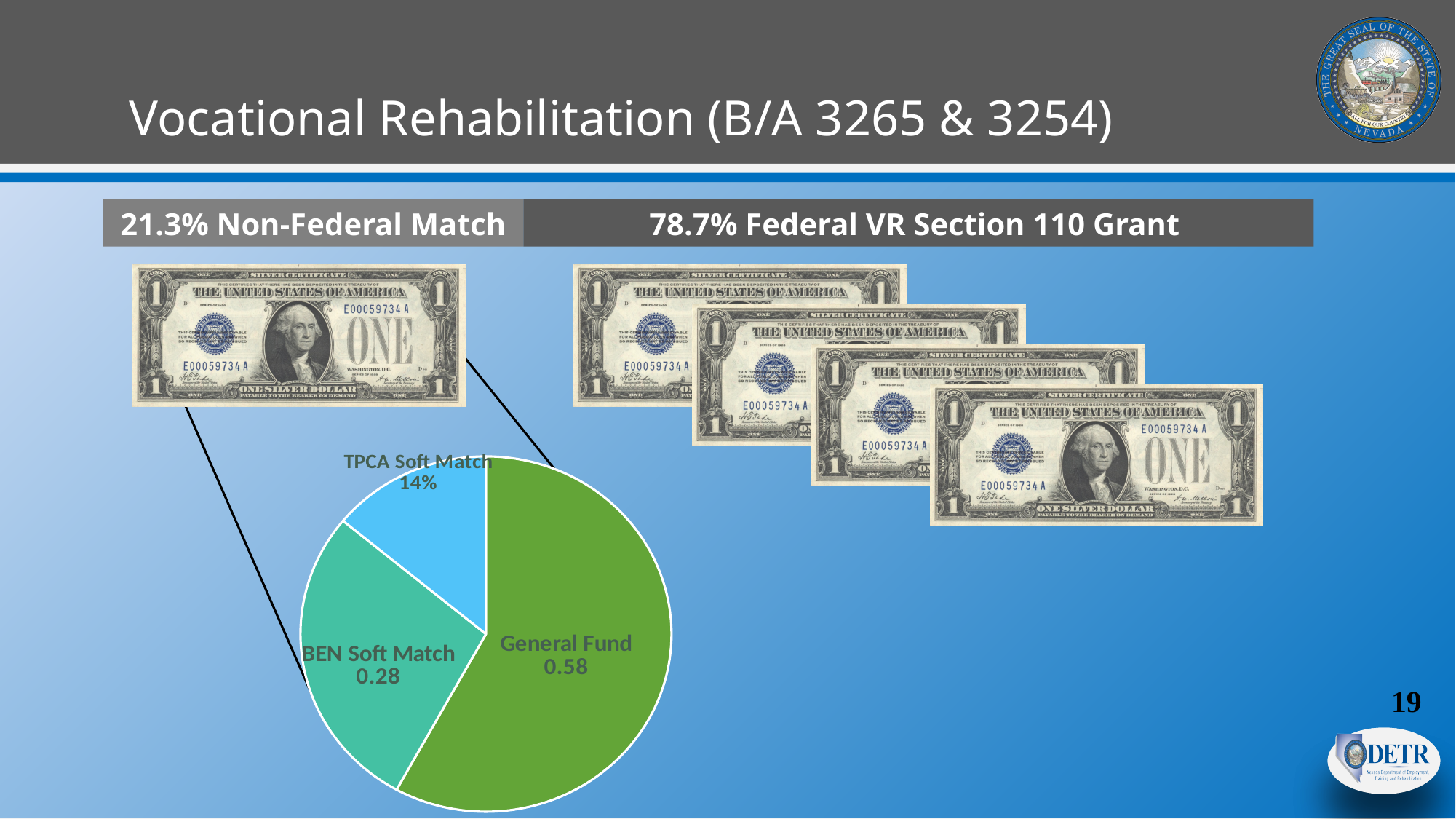
What colour is the General Fund slice of the pie chart? green What value is shown for the BEN Soft Match slice of the pie chart? 0.28 What is the difference between the General Fund value and the BEN Soft Match value in the pie chart? 0.30 What value is shown for the General Fund slice of the pie chart? 0.58 Which is larger in the pie chart, General Fund or BEN Soft Match? General Fund Which slice of the pie chart is the largest? General Fund What value is shown for the TPCA Soft Match slice of the pie chart? 14% What kind of chart is shown on the slide? pie chart Which slice of the pie chart is the smallest? TPCA Soft Match How many slices does the pie chart have? 3 Which is larger in the pie chart, BEN Soft Match or TPCA Soft Match? BEN Soft Match What colour is the TPCA Soft Match slice of the pie chart? light blue